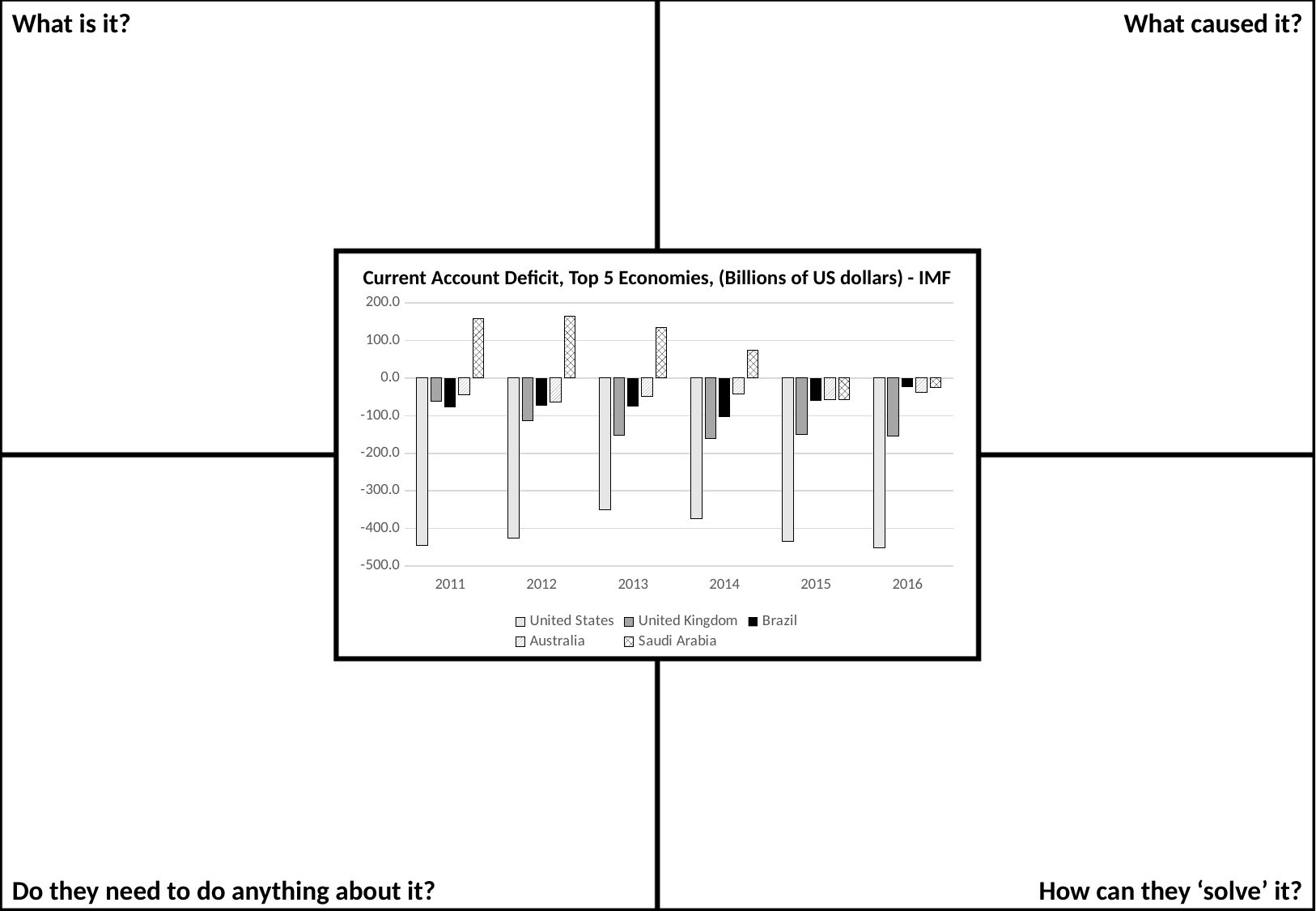
Which is larger, the value for United Kingdom in 2011 or in 2014? 2011 Which series has the lowest (most negative) value in 2011? United States Which series has the highest value in 2012? Saudi Arabia What is the title of the chart? Current Account Deficit, Top 5 Economies, (Billions of US dollars) - IMF Do the values for Saudi Arabia rise or fall from 2012 to 2016? fall Is the value for Saudi Arabia in 2012 greater or less than 100.0? greater What kind of chart is shown on the slide? bar chart Is the value for United States in 2013 greater or less than -300.0? less How many series does the legend list? 5 Is the value for United Kingdom in 2013 greater or less than -100.0? less How many years are shown on the x axis? 6